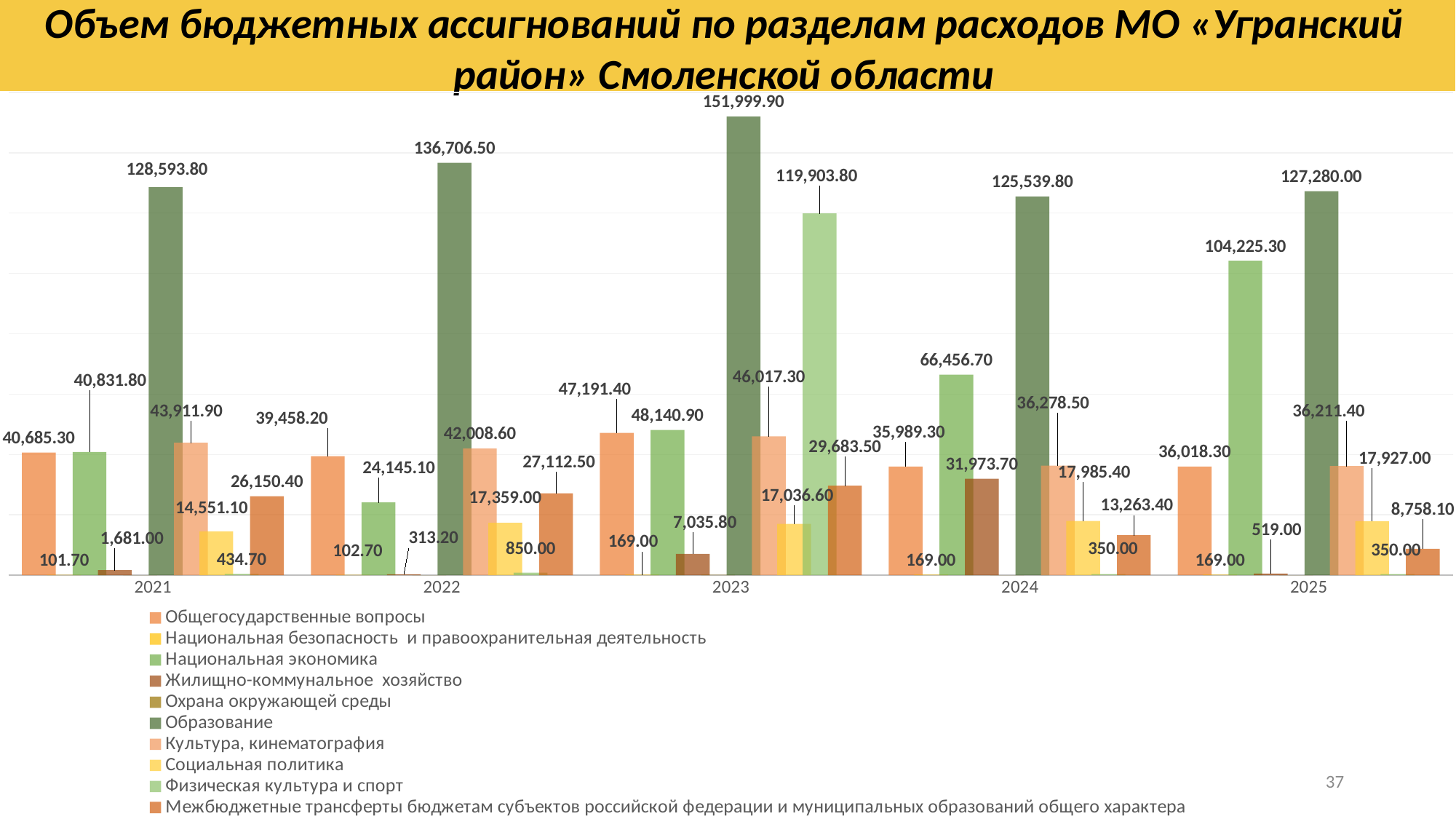
What is the value for Образование in 2023? 151,999.90 What type of chart is shown on the slide? bar chart In which year is the value for Образование the highest? 2023 What is the value for Физическая культура и спорт in 2023? 119,903.80 What is the value for Межбюджетные трансферты бюджетам субъектов российской федерации и муниципальных образований общего характера in 2025? 8,758.10 Which series is shown in dark green in the legend? Образование How many years are shown along the x axis? 5 Which is larger: Физическая культура и спорт in 2023 or Национальная экономика in 2025? Физическая культура и спорт in 2023 What is the difference between the Образование values in 2023 and 2022? 15,293.40 What is the value for Образование in 2021? 128,593.80 How many series does the legend list? 10 In which year is the value for Образование the lowest? 2024